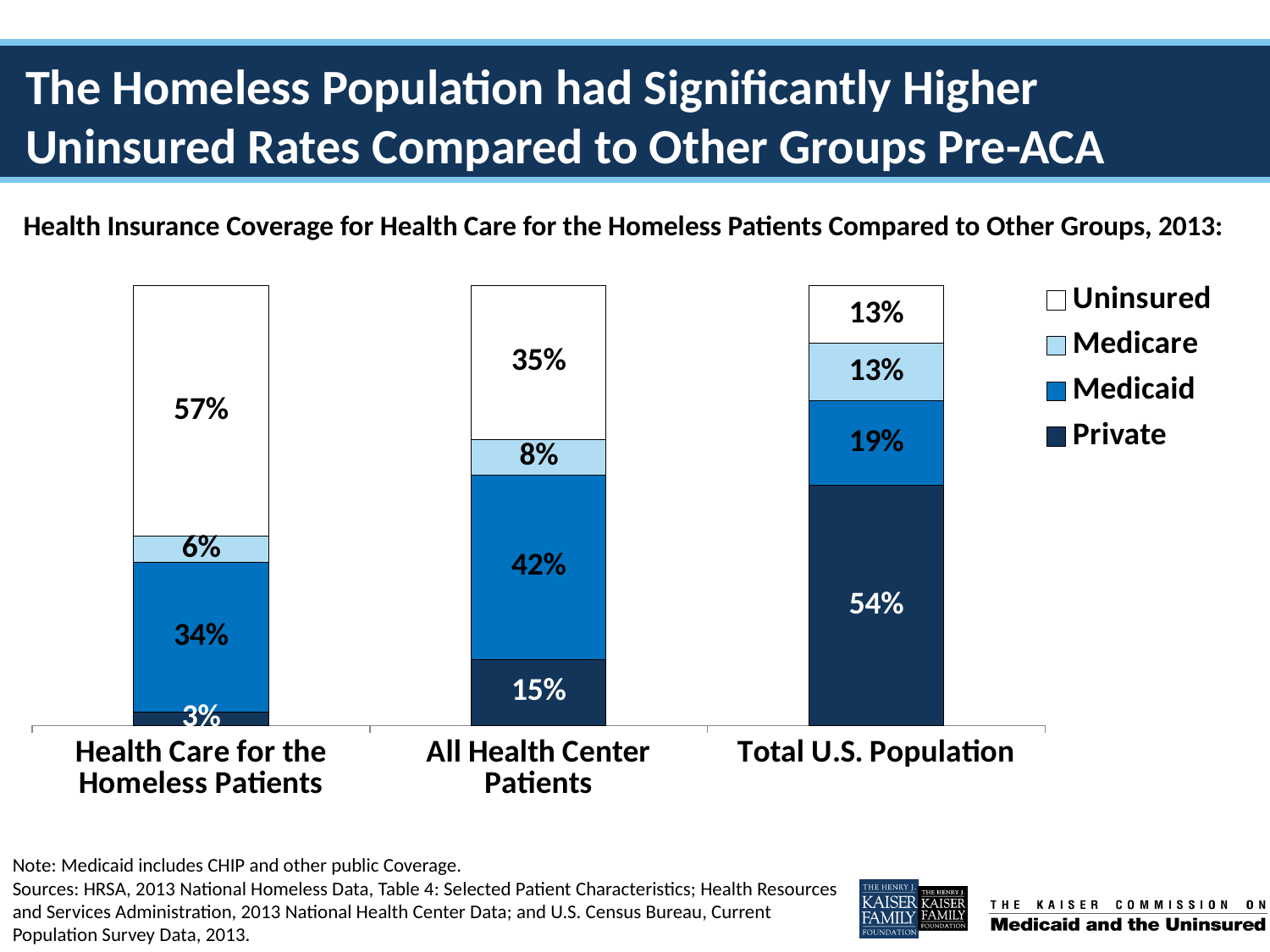
Which group has the lowest Private coverage rate? Health Care for the Homeless Patients What is the total of the stacked bar for All Health Center Patients? 100% How many series does the legend list? 4 What share of All Health Center Patients have Medicaid coverage? 42% What kind of chart is shown on the slide? Stacked bar chart How many groups are shown on the x axis of the chart? 3 What is the Private coverage value for the Total U.S. Population? 54% What is the Medicare value for Health Care for the Homeless Patients? 6% Which group has the highest uninsured rate? Health Care for the Homeless Patients Which is larger: the Medicaid share for All Health Center Patients or the Medicaid share for the Total U.S. Population? All Health Center Patients What is the difference between the uninsured rate for Health Care for the Homeless Patients and the uninsured rate for the Total U.S. Population? 44% What is the uninsured rate for Health Care for the Homeless Patients? 57%